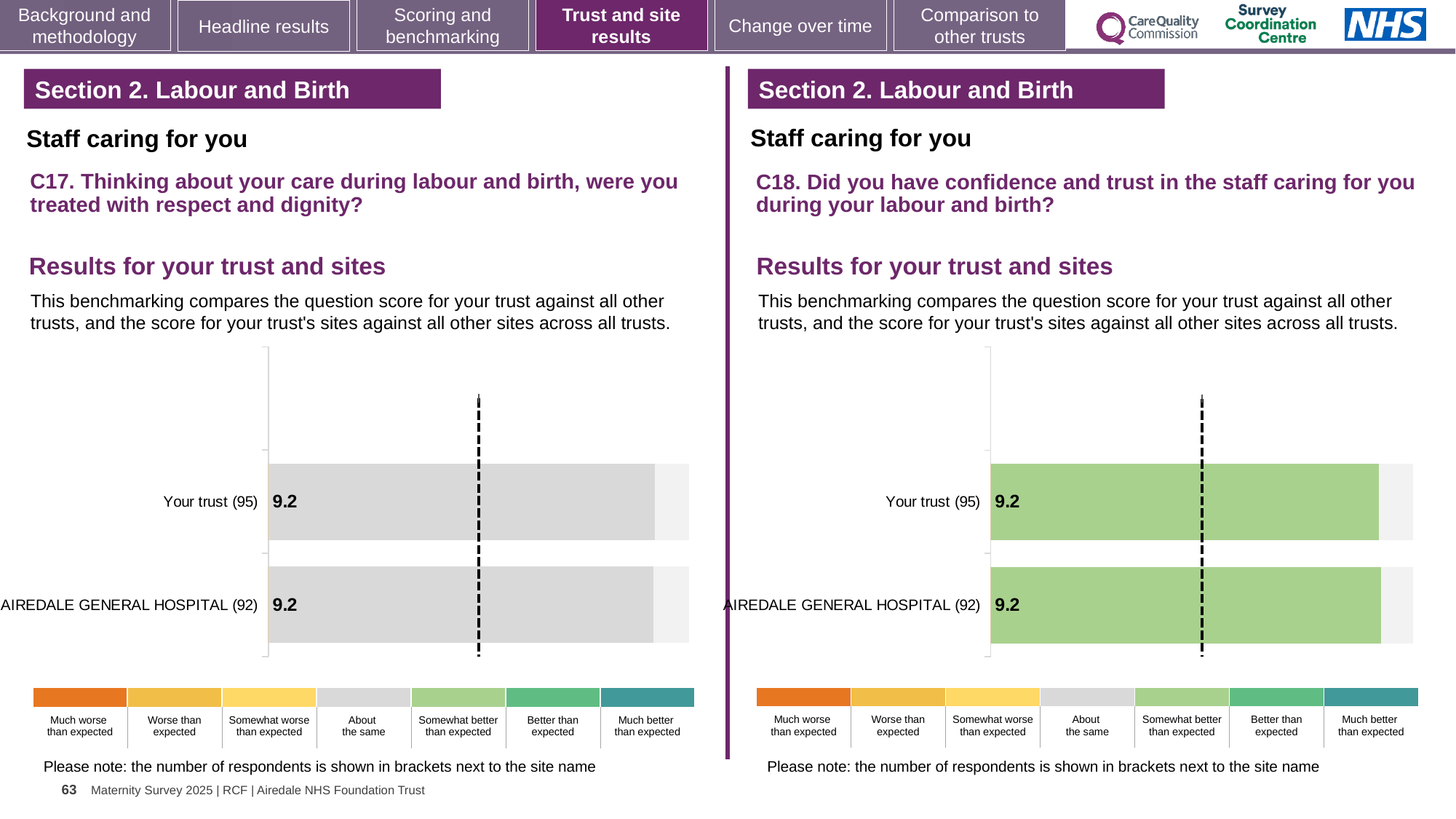
How many bars are plotted in the C18 chart on the right? 2 In the C17 chart on the left, what is the score for Your trust? 9.2 In the C17 chart on the left, what is the score for Airedale General Hospital? 9.2 What kind of chart is used for the C18 results on the right? Bar chart In the C18 chart on the right, what is the score for Airedale General Hospital? 9.2 In the C18 chart on the right, how many respondents are shown in brackets next to Airedale General Hospital? 92 In the C18 chart on the right, which benchmark category does the colour of the bars correspond to according to the legend? Somewhat better than expected In the C17 chart on the left, which benchmark category does the colour of the bars correspond to according to the legend? About the same In the C17 chart on the left, what is the difference between the score for Your trust and the score for Airedale General Hospital? 0 What kind of chart is used for the C17 results on the left? Bar chart How many bars are plotted in the C17 chart on the left? 2 In the C18 chart on the right, what is the score for Your trust? 9.2